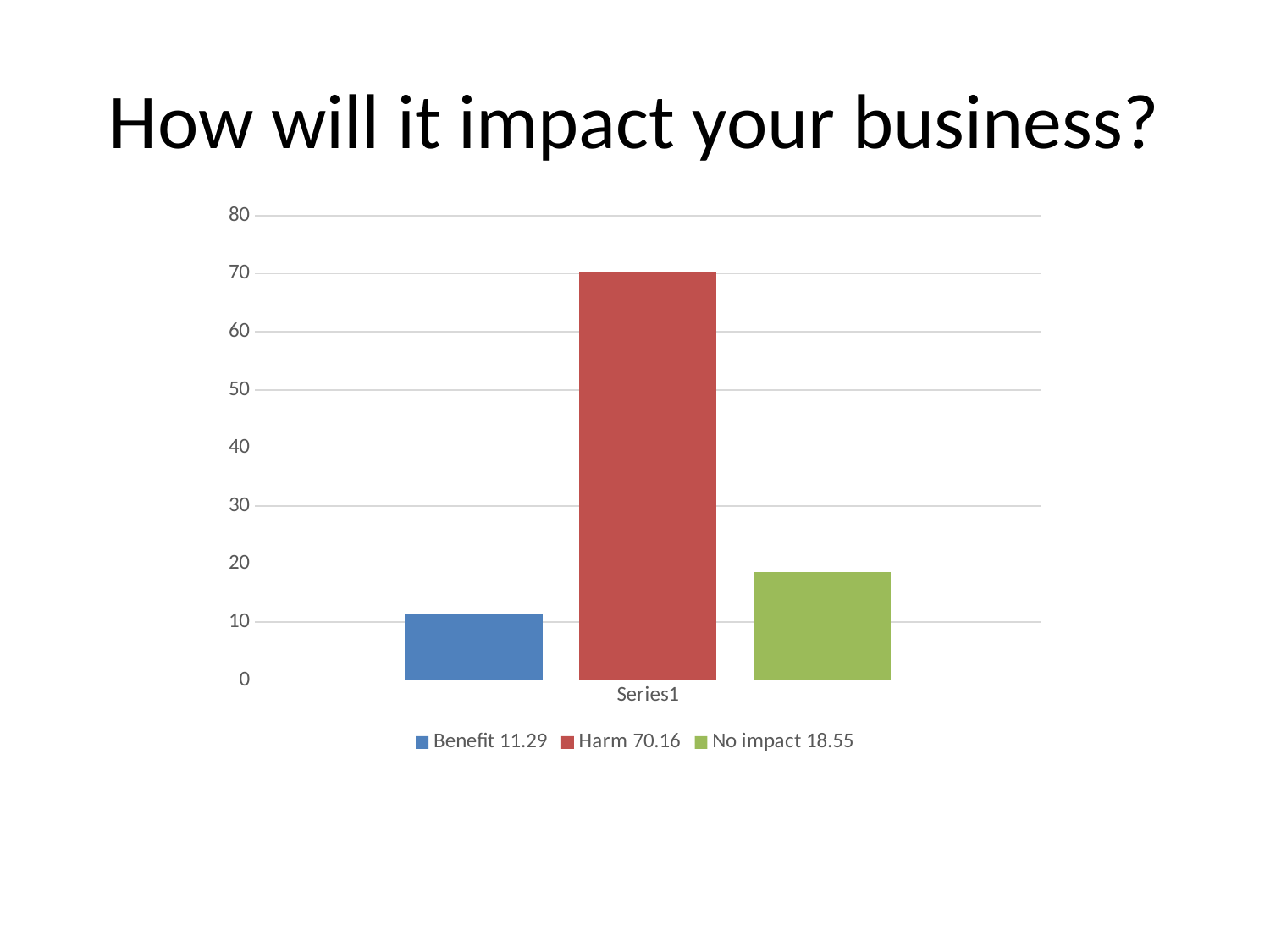
What is the difference between the Harm value and the Benefit value? 58.87 What value is shown for No impact in the legend? 18.55 What is the title of the slide? How will it impact your business? What value is shown for Benefit in the legend? 11.29 Which series has the lowest value? Benefit What value is shown for Harm in the legend? 70.16 What type of chart is shown on the slide? Bar chart Which is larger, the value for No impact or the value for Benefit? No impact Which series has the highest value? Harm How many series does the legend list? 3 Is the value for Harm greater or less than 60? greater What is the difference between the No impact value and the Benefit value? 7.26